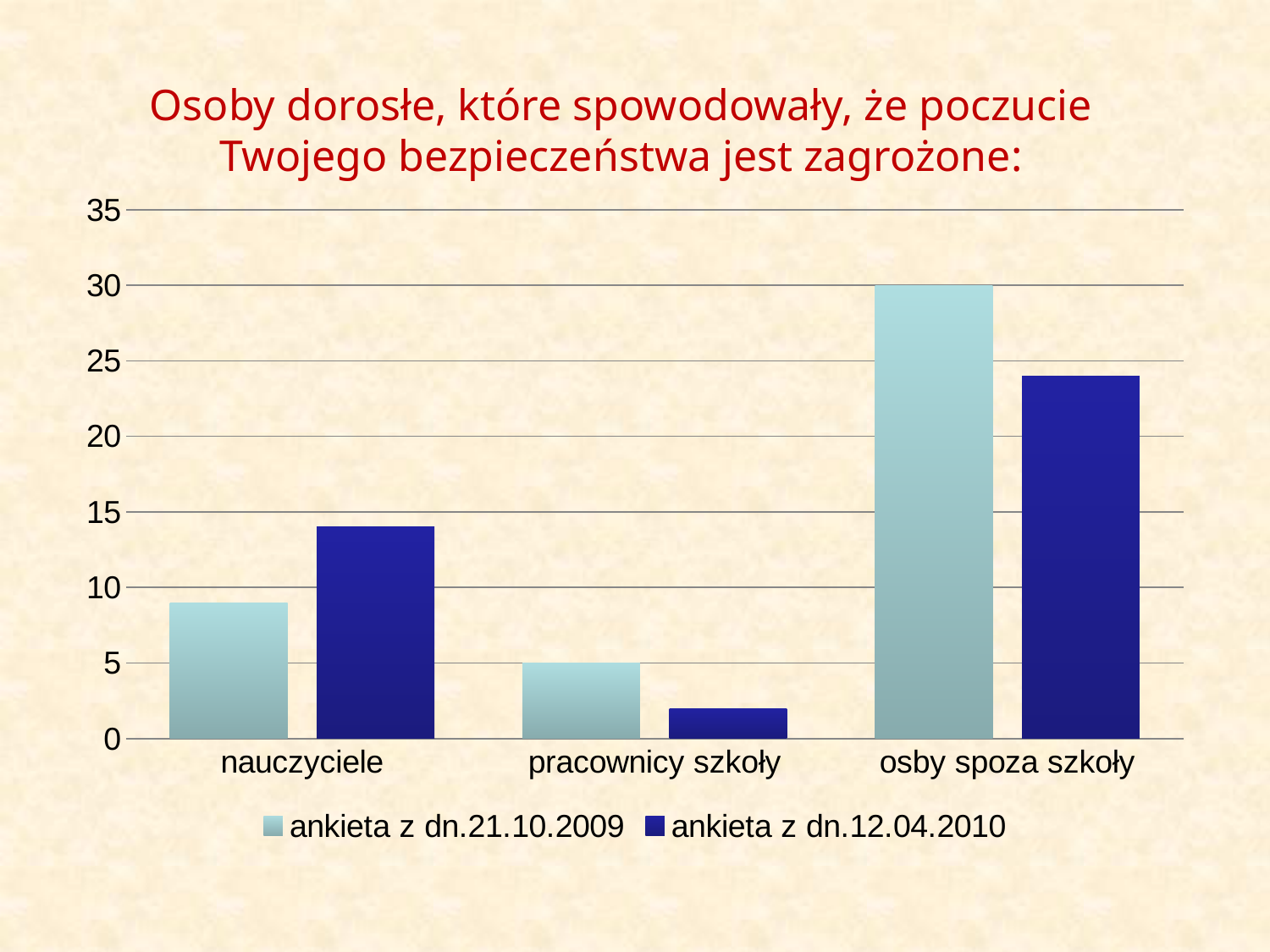
How many categories are shown on the x axis? 3 For nauczyciele, which series has the larger value: ankieta z dn.21.10.2009 or ankieta z dn.12.04.2010? ankieta z dn.12.04.2010 What kind of chart is shown on the slide? bar chart Which category has the lowest value in the ankieta z dn.12.04.2010 series? pracownicy szkoły Which category has the highest value in the ankieta z dn.12.04.2010 series? osby spoza szkoły Is the value for nauczyciele in the ankieta z dn.12.04.2010 series greater or less than 10? greater What is the value for osby spoza szkoły in the ankieta z dn.21.10.2009 series? 30 What is the value for pracownicy szkoły in the ankieta z dn.21.10.2009 series? 5 How many series does the legend list? 2 Is the value for nauczyciele in the ankieta z dn.21.10.2009 series greater or less than 10? less Is the value for osby spoza szkoły in the ankieta z dn.12.04.2010 series greater or less than 25? less What is the difference between the ankieta z dn.21.10.2009 values for osby spoza szkoły and pracownicy szkoły? 25